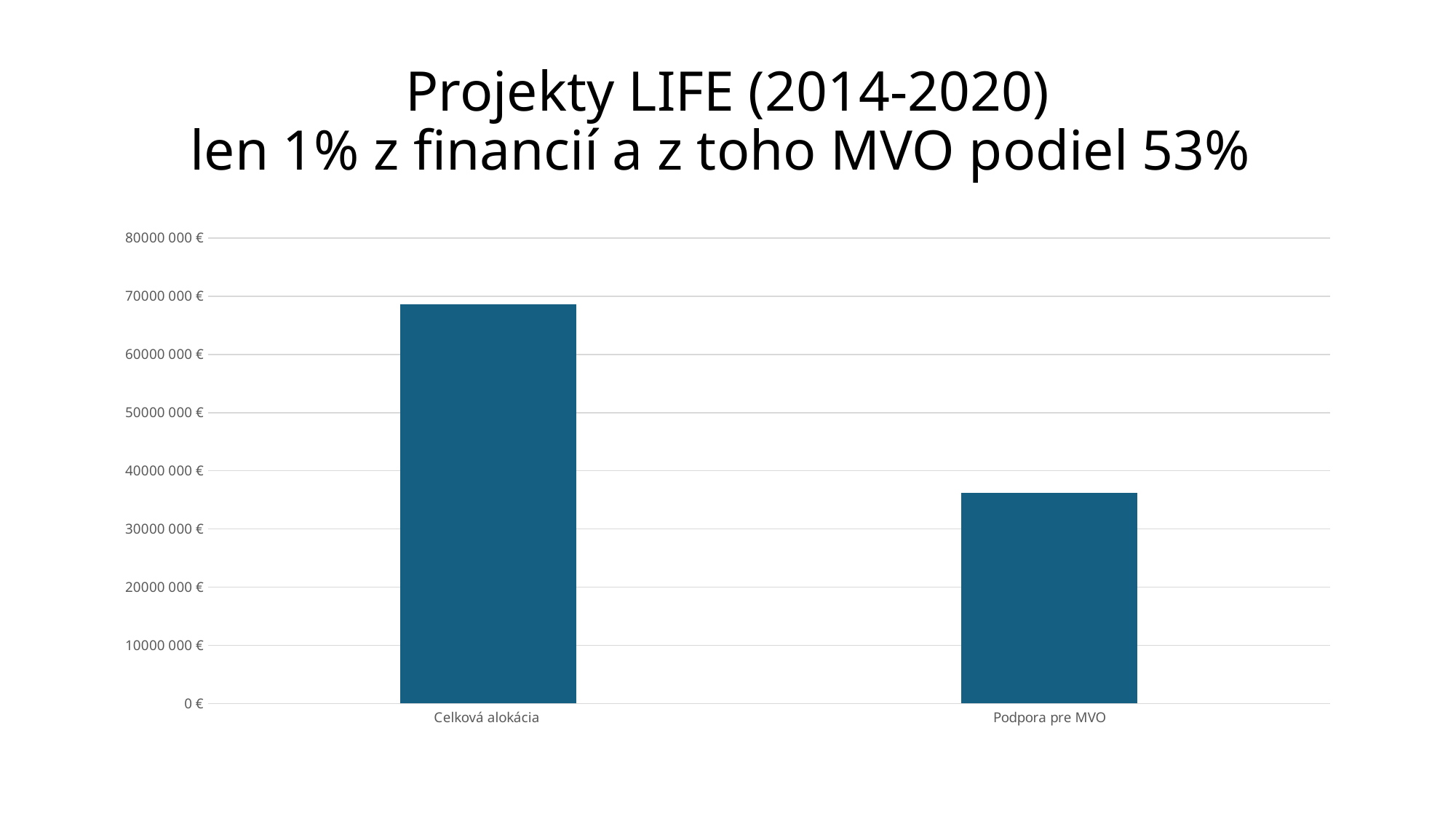
Is the value for Podpora pre MVO greater or less than 30000 000 €? greater Is the value for Celková alokácia greater or less than 60000 000 €? greater What kind of chart is shown on the slide? bar chart What is the highest value shown on the vertical axis? 80000 000 € Which is larger, the value for Celková alokácia or the value for Podpora pre MVO? Celková alokácia Which category has the highest value? Celková alokácia How many bars does the chart show? 2 What is the title of the chart? Projekty LIFE (2014-2020) len 1% z financií a z toho MVO podiel 53% Is the value for Podpora pre MVO greater or less than 40000 000 €? less Which category has the lowest value? Podpora pre MVO